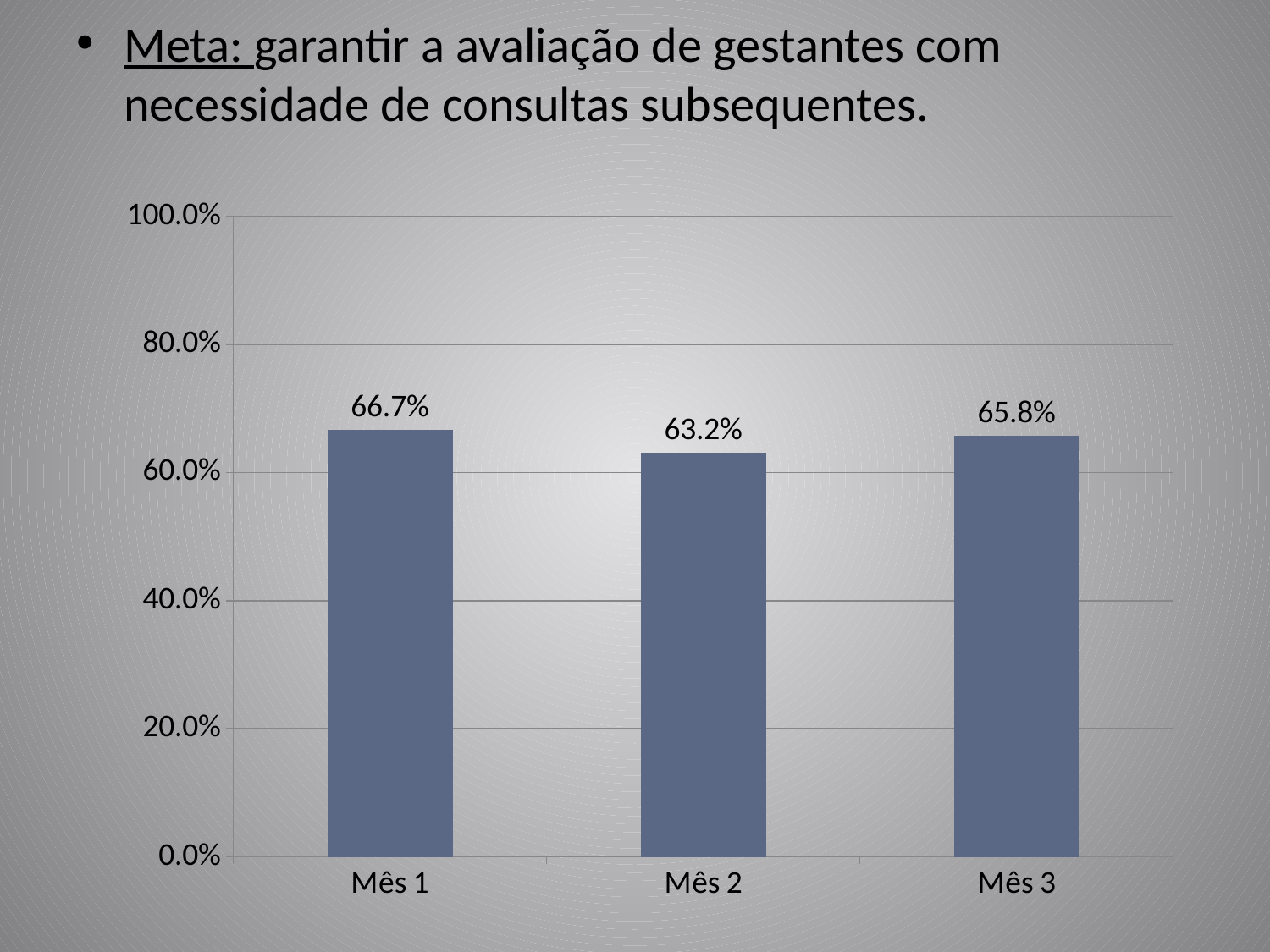
What is the difference between the values for Mês 3 and Mês 2? 2.6% Is the value for Mês 2 greater or less than 80.0%? less Which month has the highest value? Mês 1 What is the maximum value shown on the y axis? 100.0% Which is larger, the value for Mês 1 or the value for Mês 3? Mês 1 How many categories are shown on the x axis? 3 What is the value for Mês 3? 65.8% What is the value for Mês 2? 63.2% Which month has the lowest value? Mês 2 What is the difference between the values for Mês 1 and Mês 2? 3.5% What is the value for Mês 1? 66.7% What kind of chart is shown on the slide? bar chart